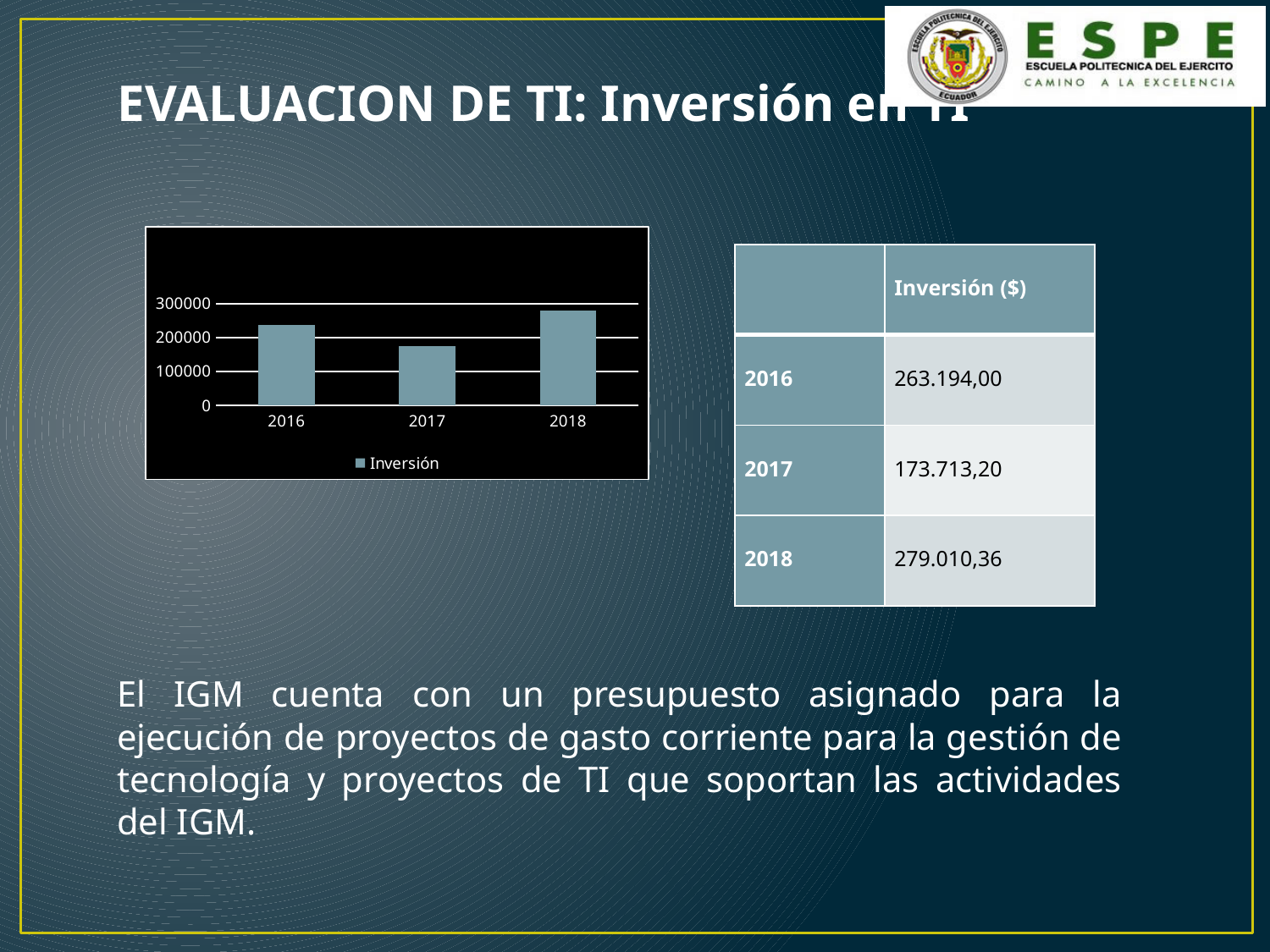
What is the name of the series shown in the chart legend? Inversión Which is larger, the investment in 2016 or in 2017? 2016 How many years (categories) are plotted on the chart? 3 What is the Inversión ($) value for 2017 according to the slide? 173.713,20 Does the investment rise or fall from 2017 to 2018? rise How many series does the chart legend list? 1 Is the value for 2017 in the chart greater or less than 200000? less Which year has the lowest investment (Inversión)? 2017 Is the value for 2016 in the chart greater or less than 200000? greater Which year has the highest investment (Inversión)? 2018 What kind of chart is shown on the slide? bar chart What is the Inversión ($) value for 2018 according to the slide? 279.010,36